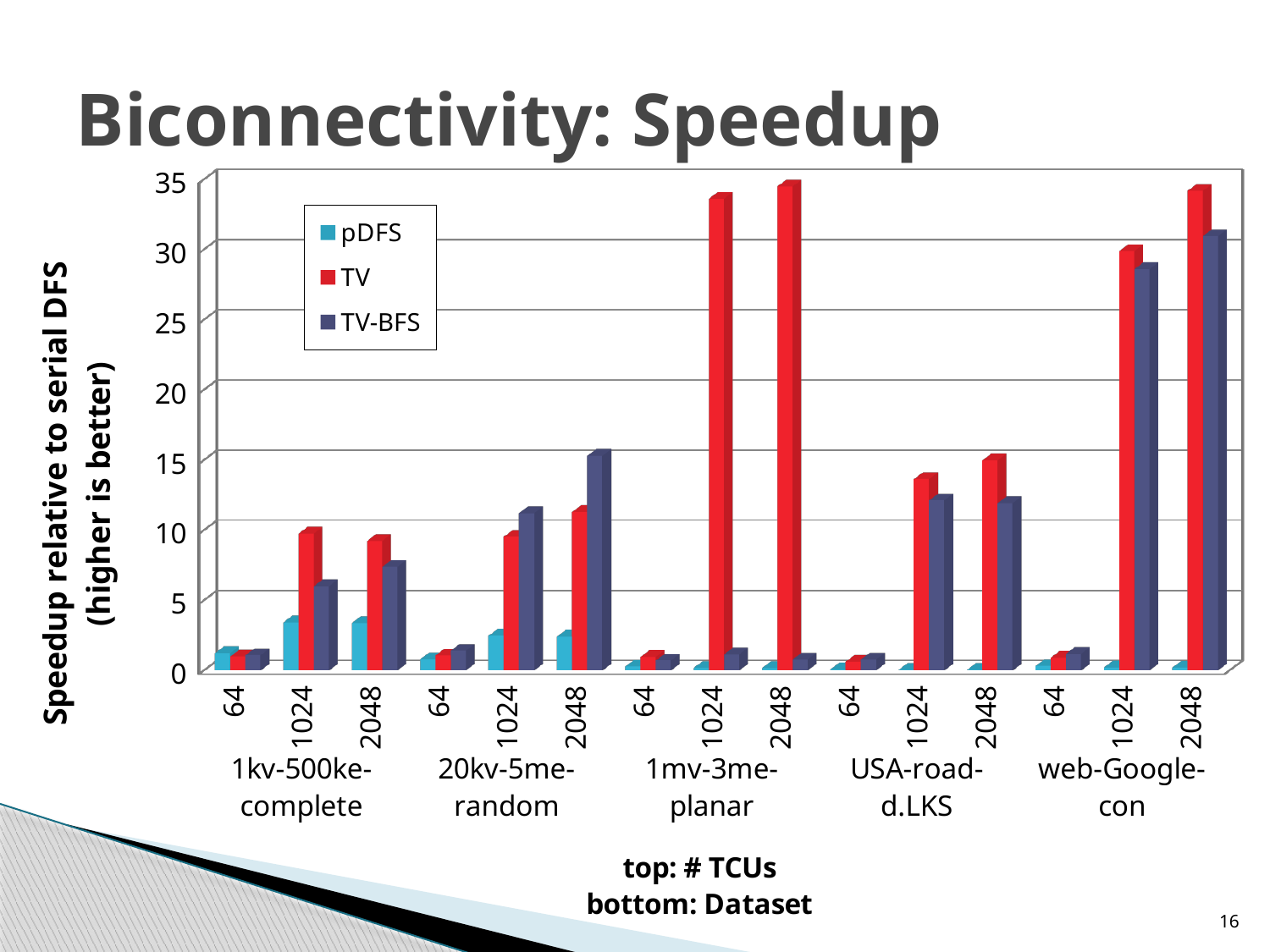
Is the pDFS speedup for 1kv-500ke-complete at 1024 TCUs greater or less than 5? less What kind of chart is shown on the slide? bar chart How many series does the legend list? 3 Which dataset has the highest TV-BFS speedup? web-Google-con How many TCU settings are shown for each dataset? 3 Is the TV speedup for USA-road-d.LKS at 2048 TCUs greater or less than 10? greater What is the y-axis title of the chart? Speedup relative to serial DFS (higher is better) For 1mv-3me-planar at 1024 TCUs, which series has the larger speedup, TV or TV-BFS? TV How many datasets are shown along the x axis? 5 Is the TV speedup for 1mv-3me-planar at 2048 TCUs greater or less than 30? greater For 20kv-5me-random at 2048 TCUs, which series has the larger speedup, TV or TV-BFS? TV-BFS